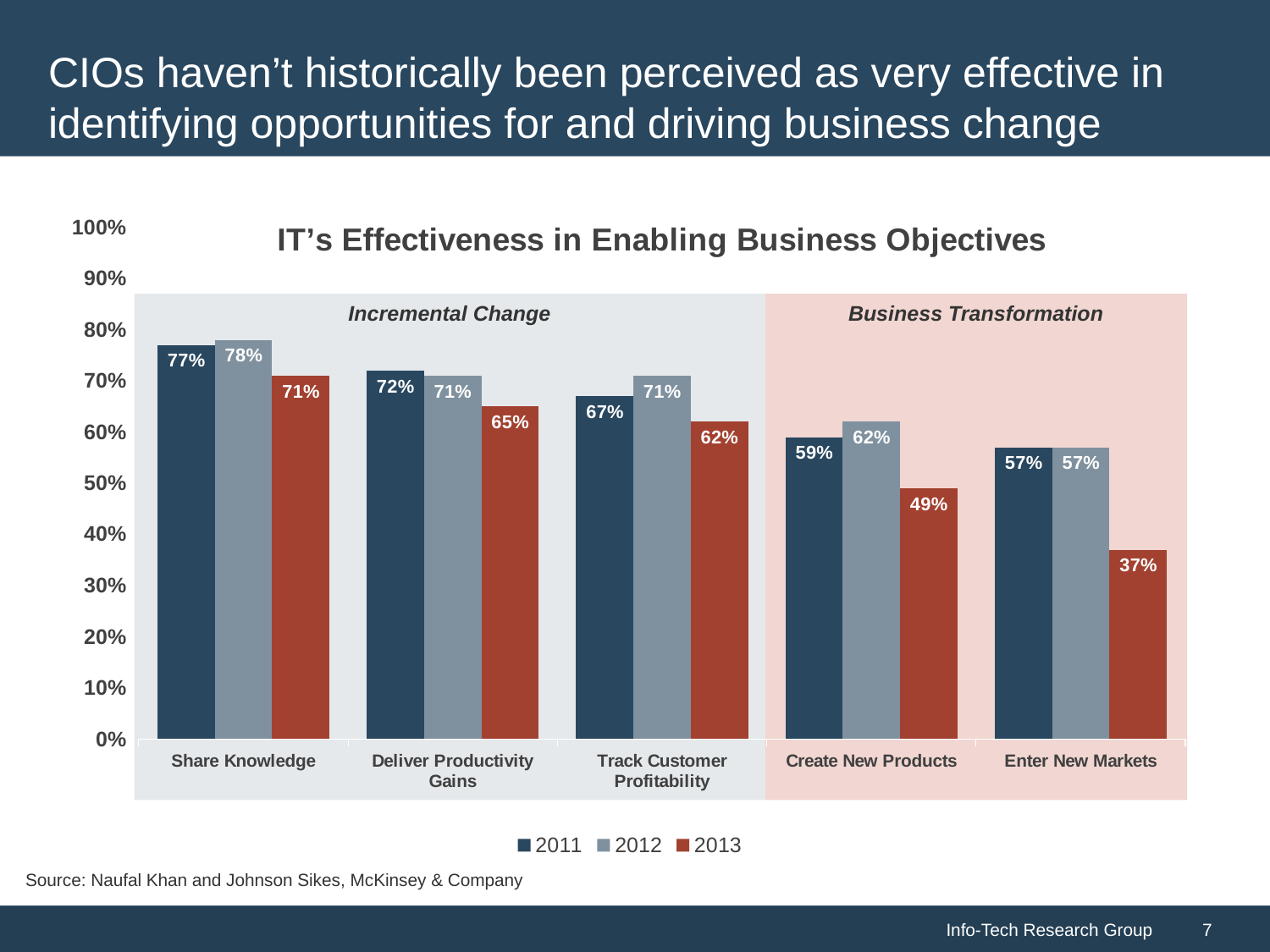
Which category has the lowest 2013 value? Enter New Markets Which is larger for Track Customer Profitability: the 2011 value or the 2012 value? 2012 Is the 2013 value for Enter New Markets greater or less than 40%? less What is the 2013 value for Enter New Markets? 37% What is the 2012 value for Create New Products? 62% How many categories are shown on the x axis? 5 How many series does the legend list? 3 Which category has the highest 2012 value? Share Knowledge What is the difference between the 2011 and 2013 values for Create New Products? 10% What kind of chart is shown? bar chart What is the title of the chart? IT's Effectiveness in Enabling Business Objectives What is the 2011 value for Deliver Productivity Gains? 72%